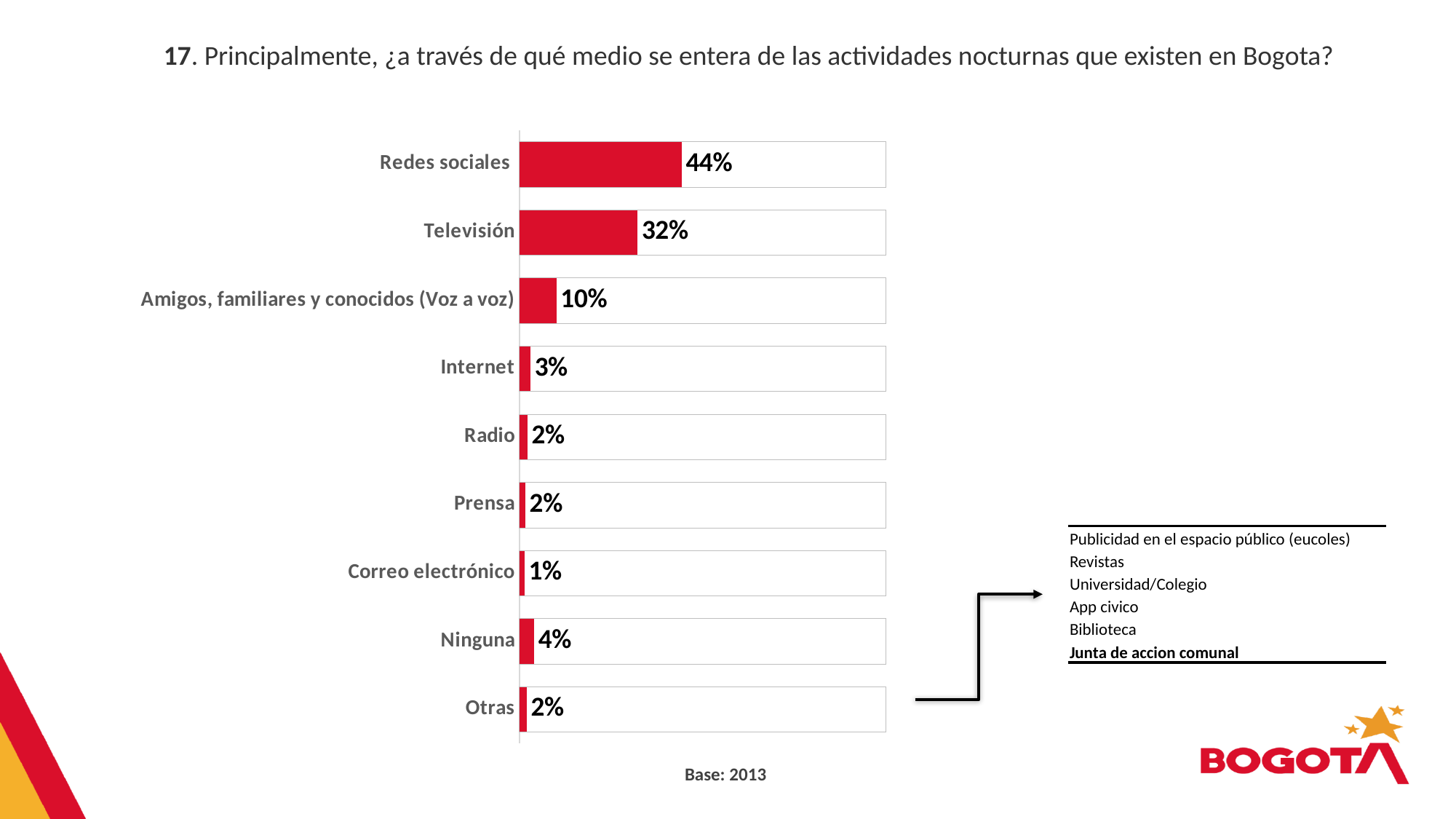
Which category has the highest value? Redes sociales Which category has the lowest value? Correo electrónico What kind of chart is shown on the slide? Bar chart What percentage is shown for Amigos, familiares y conocidos (Voz a voz)? 10% What colour are the bars in the chart? Red What percentage is shown for Redes sociales? 44% Which is larger, the value for Internet or the value for Ninguna? Ninguna What is the base (sample size) noted below the chart? 2013 What percentage is shown for Ninguna? 4% What is the difference between the values for Redes sociales and Televisión? 12% How many categories are shown in the chart? 9 What percentage is shown for Televisión? 32%